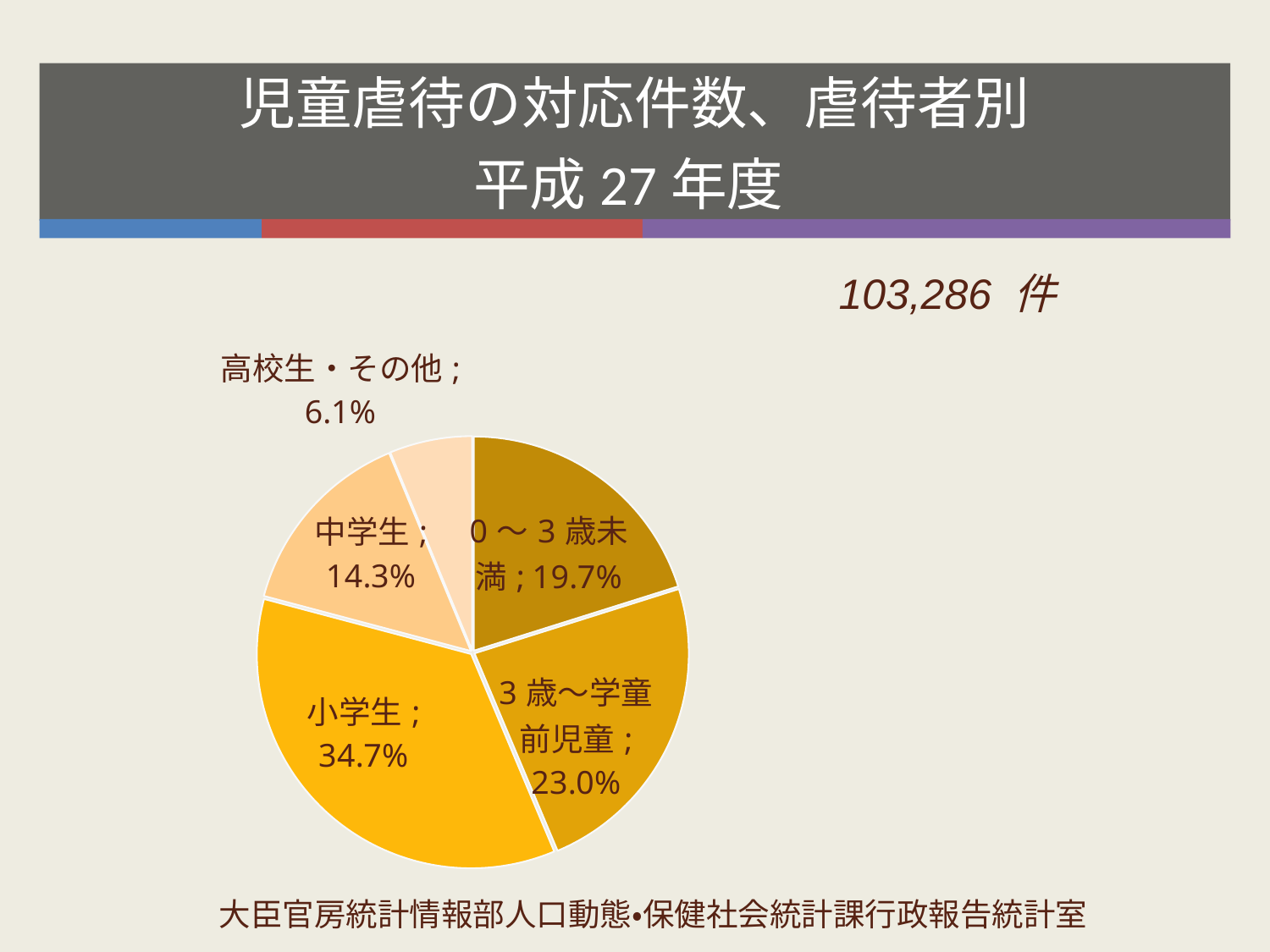
What share of the pie does 高校生・その他 account for? 6.1% How many slices does the pie chart have? 5 Which category has the smallest slice of the pie? 高校生・その他 Which is larger, the share for 3歳～学童前児童 or the share for 0～3歳未満? 3歳～学童前児童 What total number of cases is shown above the pie chart? 103,286 件 What kind of chart is shown on the slide? pie chart What share of the pie does 0～3歳未満 account for? 19.7% What share of the pie does 小学生 account for? 34.7% What share of the pie does 3歳～学童前児童 account for? 23.0% What share of the pie does 中学生 account for? 14.3% Which category has the largest slice of the pie? 小学生 What is the difference in percentage points between the 小学生 share and the 中学生 share? 20.4